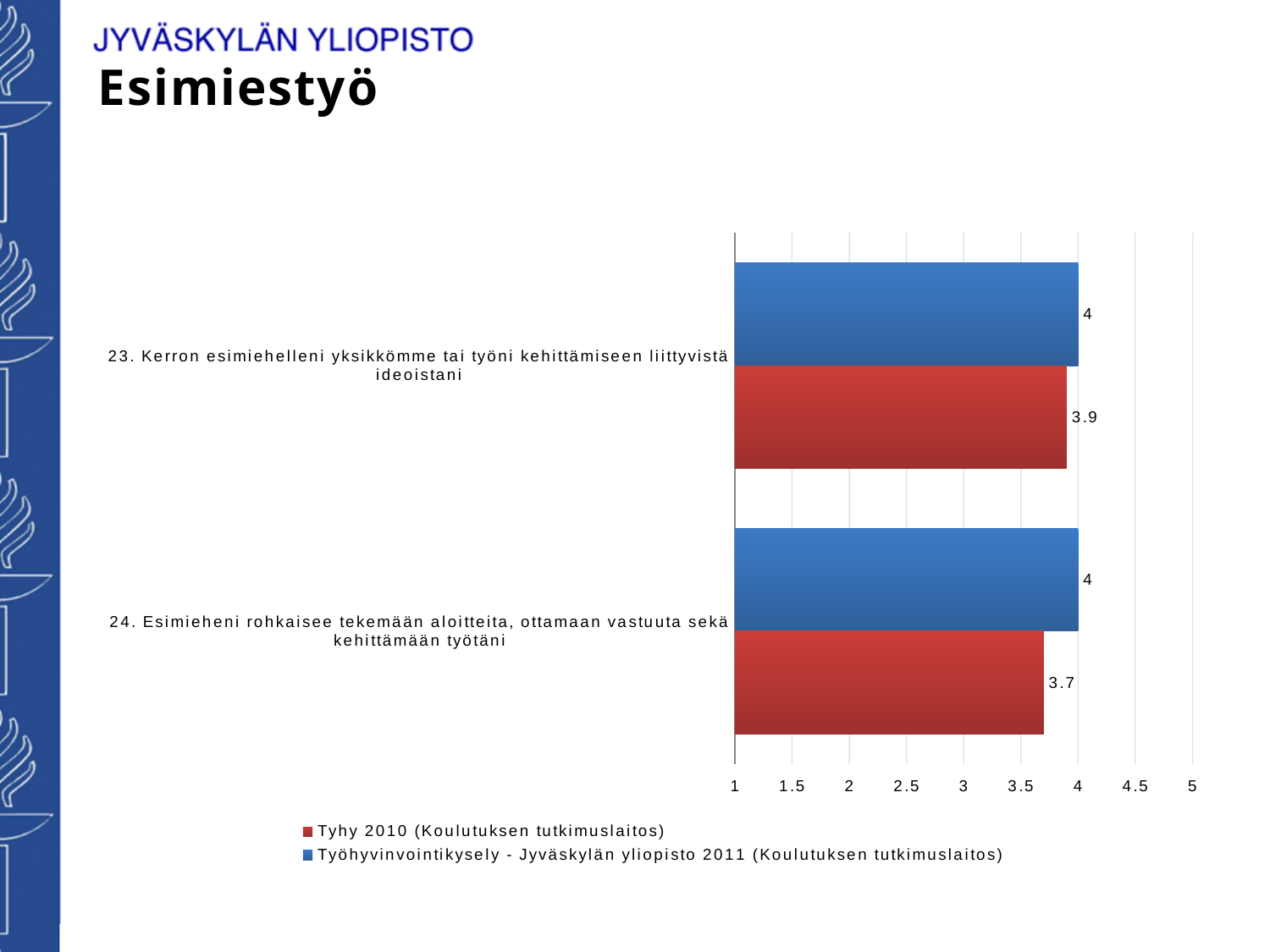
What is the Työhyvinvointikysely 2011 value for statement 23? 4 What is the difference between the 2011 and 2010 values for statement 24? 0.3 Which colour represents the Tyhy 2010 series in the chart? red What is the Työhyvinvointikysely 2011 value for statement 24? 4 What is the Tyhy 2010 value for statement 23 (Kerron esimiehelleni yksikkömme tai työni kehittämiseen liittyvistä ideoistani)? 3.9 What kind of chart is shown on the slide? bar chart Which statement has the lowest Tyhy 2010 value? 24. Esimieheni rohkaisee tekemään aloitteita, ottamaan vastuuta sekä kehittämään työtäni How many series does the legend list? 2 What is the difference between the 2011 and 2010 values for statement 23? 0.1 For statement 24, which series has the larger value, Tyhy 2010 or Työhyvinvointikysely 2011? Työhyvinvointikysely - Jyväskylän yliopisto 2011 (Koulutuksen tutkimuslaitos) What is the Tyhy 2010 value for statement 24 (Esimieheni rohkaisee tekemään aloitteita, ottamaan vastuuta sekä kehittämään työtäni)? 3.7 How many categories (statements) are plotted in the chart? 2